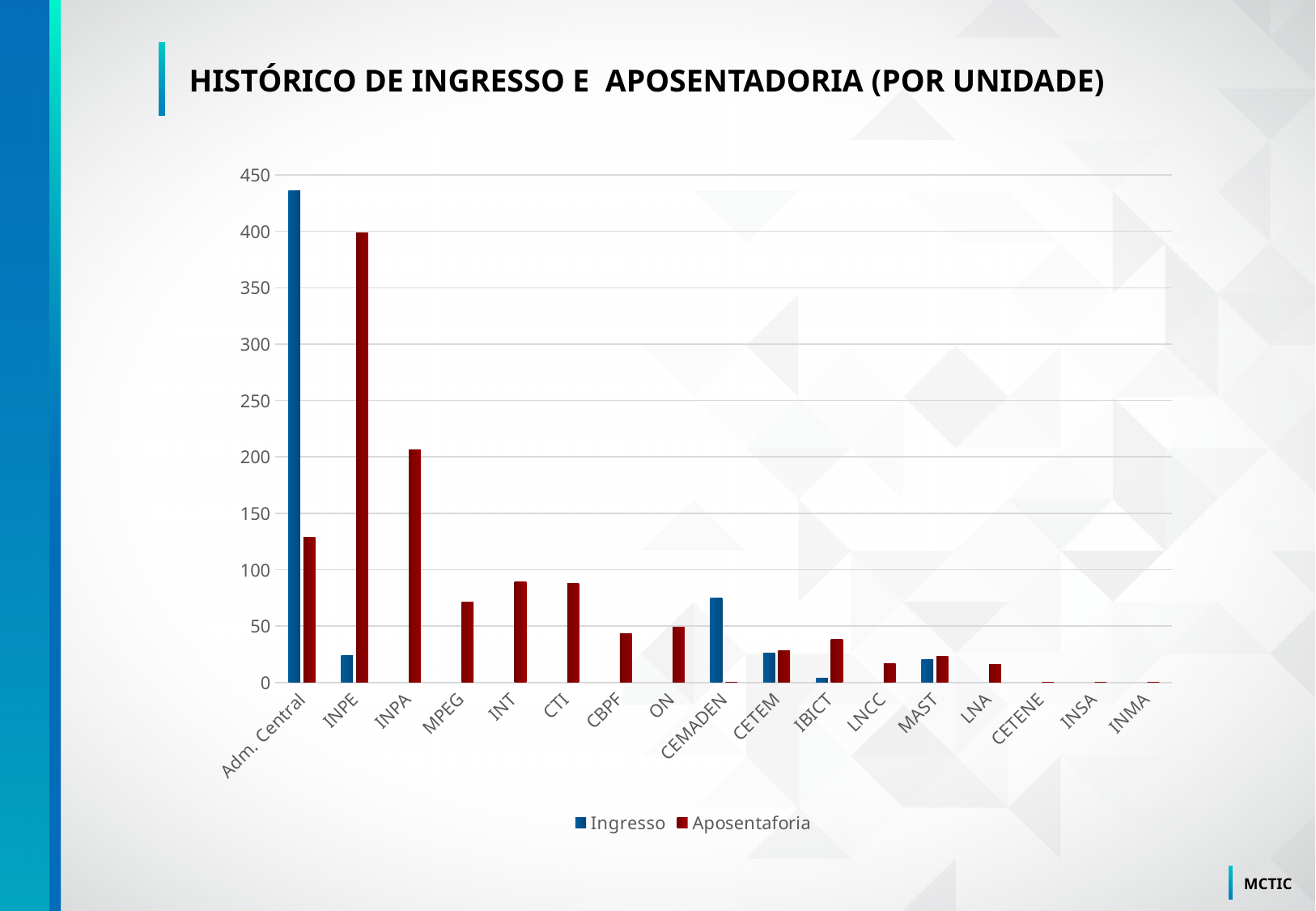
Which unit has the highest Aposentadoria value? INPE For INPE, which is larger: Ingresso or Aposentadoria? Aposentadoria Is the Ingresso value for Adm. Central greater or less than 400? greater What colour are the Ingresso bars? blue Is the Aposentadoria value for MPEG greater or less than 100? less For Adm. Central, which is larger: Ingresso or Aposentadoria? Ingresso Which unit has the highest Ingresso value? Adm. Central What kind of chart is shown on the slide? bar chart How many units (categories) are shown on the x axis? 17 Is the Aposentadoria value for INPA greater or less than 200? greater How many series does the legend list? 2